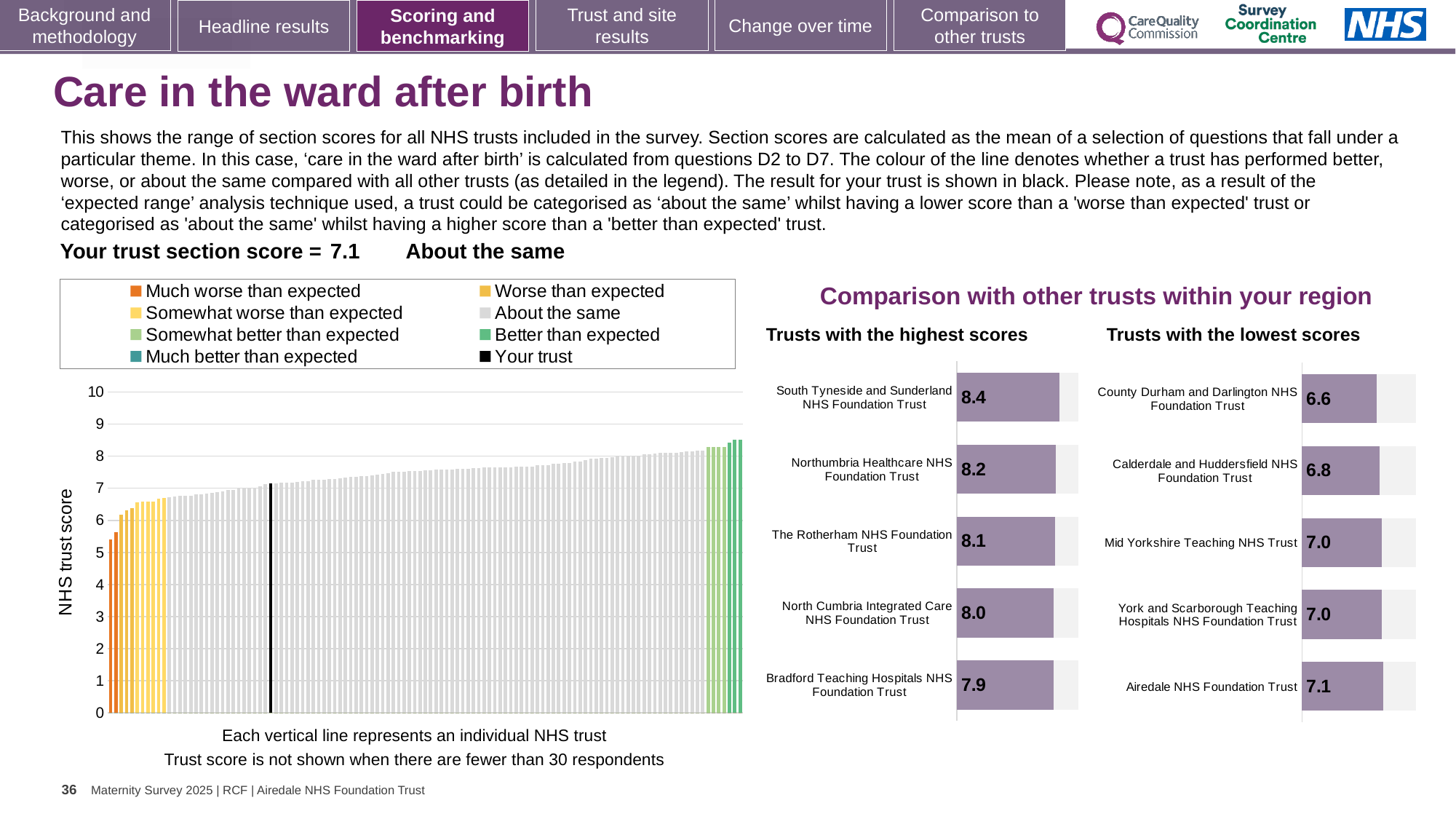
In the 'Trusts with the lowest scores' chart, what is the score for County Durham and Darlington NHS Foundation Trust? 6.6 In the 'Trusts with the lowest scores' chart, which has the larger score: Calderdale and Huddersfield NHS Foundation Trust or Mid Yorkshire Teaching NHS Trust? Mid Yorkshire Teaching NHS Trust In the 'Trusts with the lowest scores' chart, what is the difference between the scores of Airedale NHS Foundation Trust and County Durham and Darlington NHS Foundation Trust? 0.5 In the 'Trusts with the lowest scores' chart, which trust has the highest score? Airedale NHS Foundation Trust In the 'Trusts with the highest scores' chart, which trust has the lowest score? Bradford Teaching Hospitals NHS Foundation Trust In the 'Trusts with the highest scores' chart, what is the difference between the scores of South Tyneside and Sunderland NHS Foundation Trust and Bradford Teaching Hospitals NHS Foundation Trust? 0.5 How many entries does the legend above the large chart on the left list? 8 What kind of chart is the large chart on the left with the y-axis labelled 'NHS trust score'? Bar chart In the 'Trusts with the highest scores' chart, how many trusts are shown? 5 In the large chart on the left, is the value of the lowest (leftmost) bar greater or less than 6? less In the large chart on the left, do the trust scores rise or fall from left to right? Rise In the 'Trusts with the highest scores' chart, what is the score for South Tyneside and Sunderland NHS Foundation Trust? 8.4